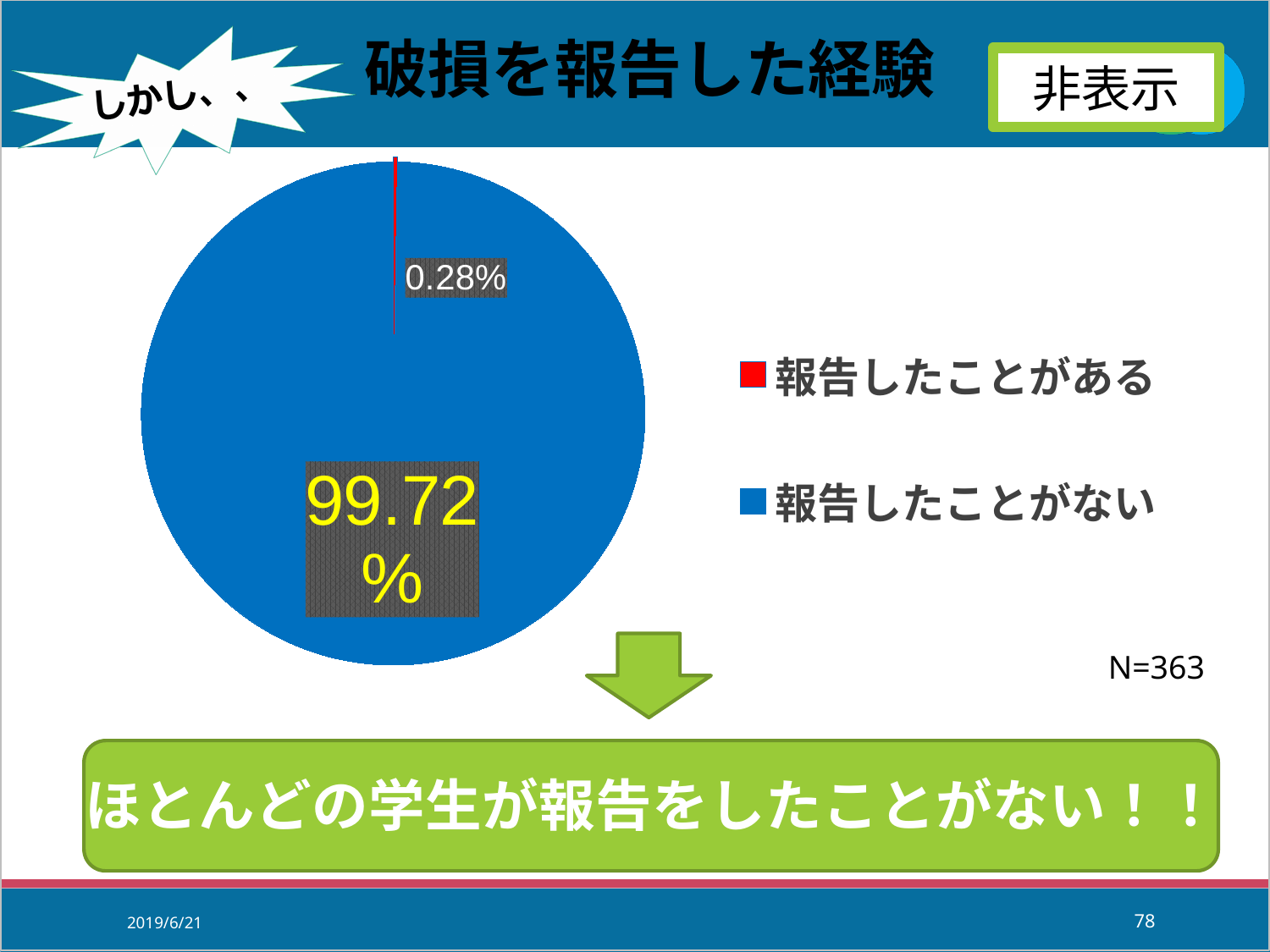
Which category has the largest slice of the pie? 報告したことがない What colour represents 報告したことがない in the pie chart? blue What is the difference in percentage points between 報告したことがない and 報告したことがある? 99.44 What is the title of the chart? 破損を報告した経験 How many entries does the legend list? 2 What share of the pie is labelled 報告したことがある? 0.28% What is the sample size (N) shown next to the chart? N=363 What kind of chart is shown on the slide? pie chart Which category has the smallest slice of the pie? 報告したことがある What share of the pie is labelled 報告したことがない? 99.72% Which is larger, the share for 報告したことがある or the share for 報告したことがない? 報告したことがない How many categories does the pie chart have? 2